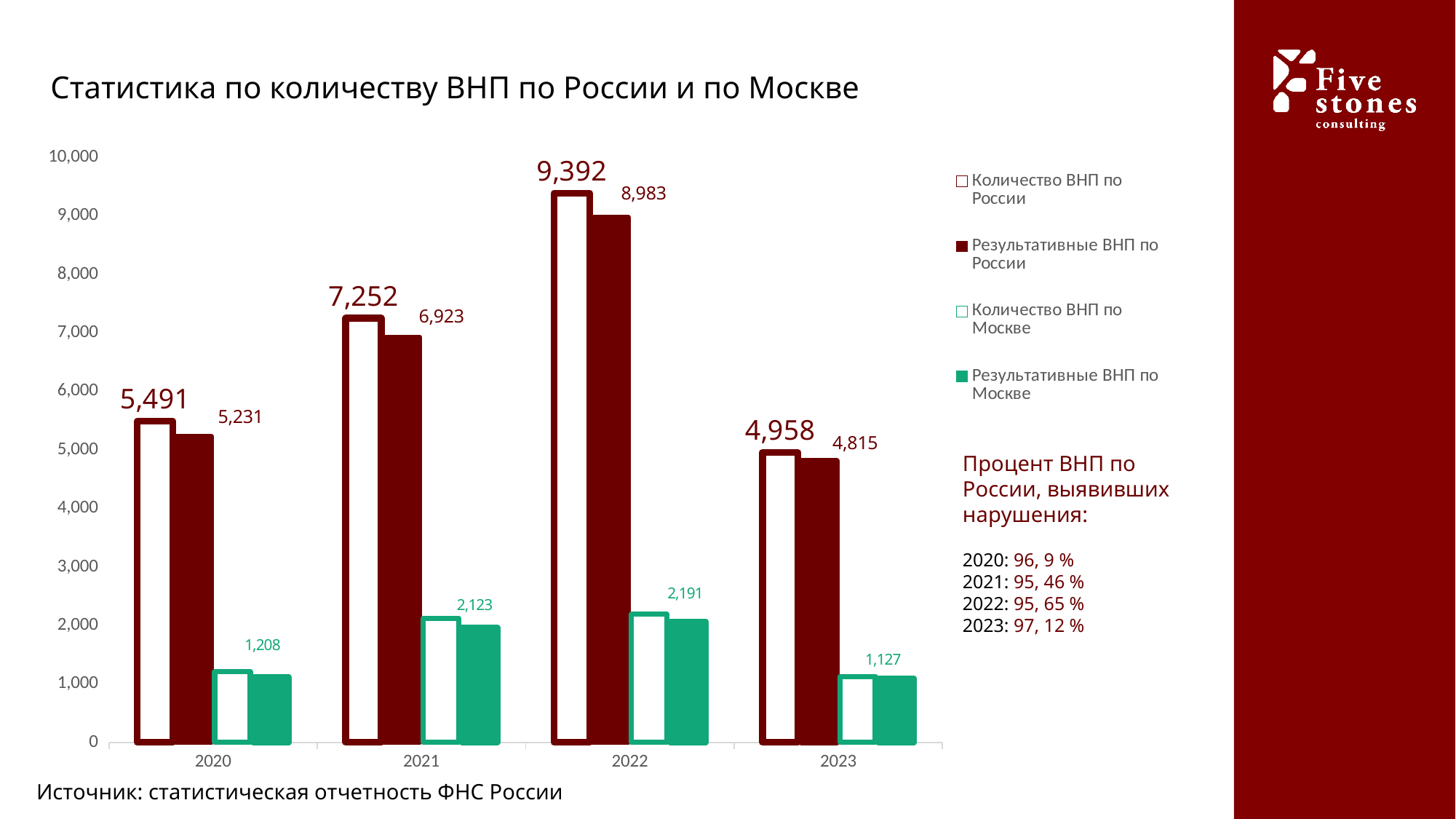
What is the value of Результативные ВНП по России for 2021? 6,923 What kind of chart is shown on the slide? Bar chart How many years are shown on the x axis? 4 In which year is Количество ВНП по России highest? 2022 How many series does the legend list? 4 What is the difference between Количество ВНП по России and Результативные ВНП по России in 2020? 260 What is the value of Количество ВНП по России for 2022? 9,392 In which year is Количество ВНП по Москве lowest? 2023 What is the title of the chart? Статистика по количеству ВНП по России и по Москве What is the value of Количество ВНП по Москве for 2023? 1,127 Which is larger: Количество ВНП по Москве in 2021 or in 2022? 2022